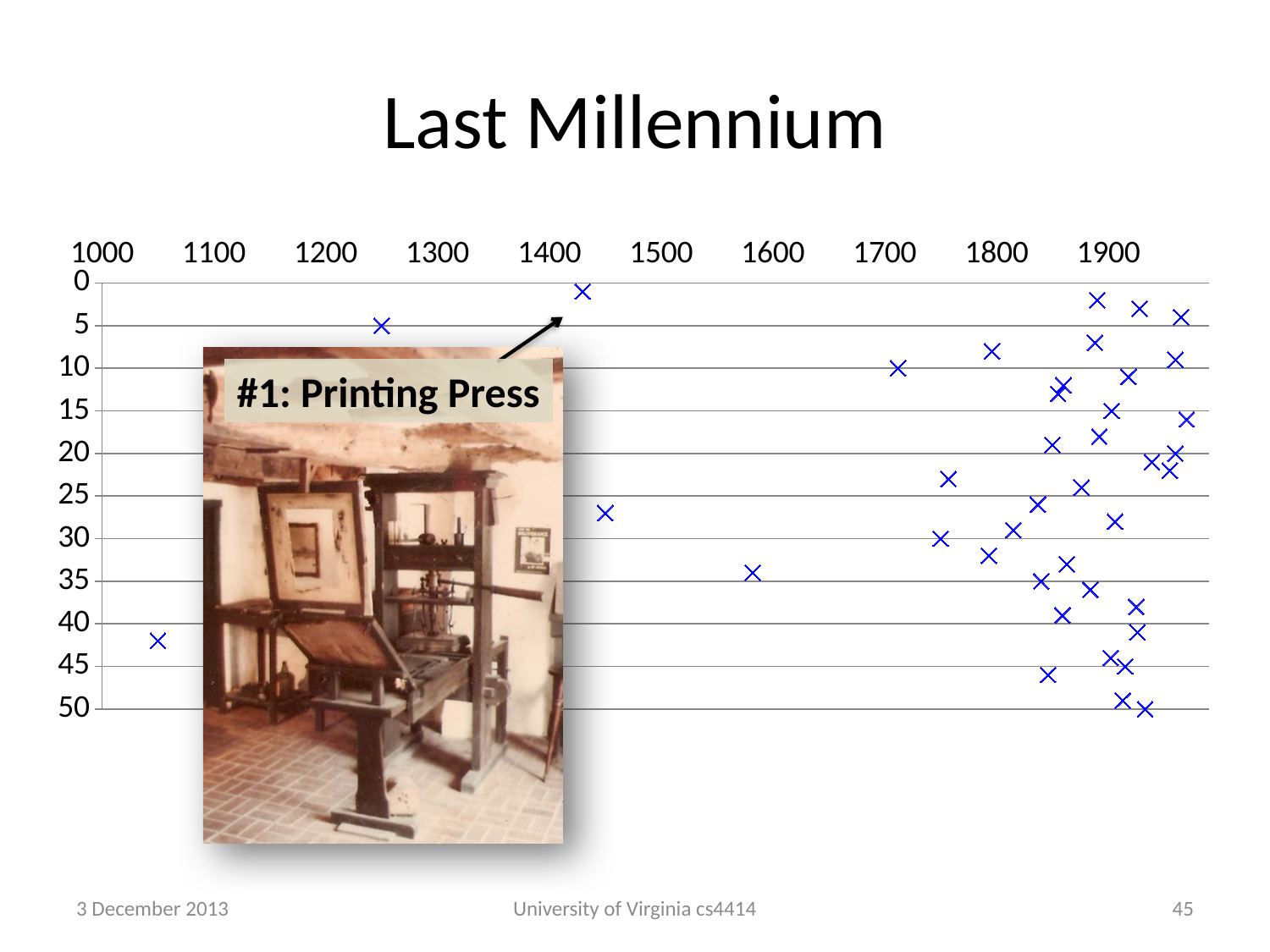
Which invention is labelled #1 on the chart? Printing Press What is the largest value labelled on the y axis? 50 What kind of chart is shown on the slide? scatter chart Is the y value of the point plotted near the year 1450 greater or less than 25? greater What is the title of the chart? Last Millennium Is the y value of the point plotted near the year 1440 (the Printing Press) greater or less than 5? less Are there more points plotted before the year 1500 or after the year 1800? after 1800 Is the y value of the point plotted near the year 1580 greater or less than 30? greater What is the highest year label shown on the x axis? 1900 What is the lowest year label shown on the x axis? 1000